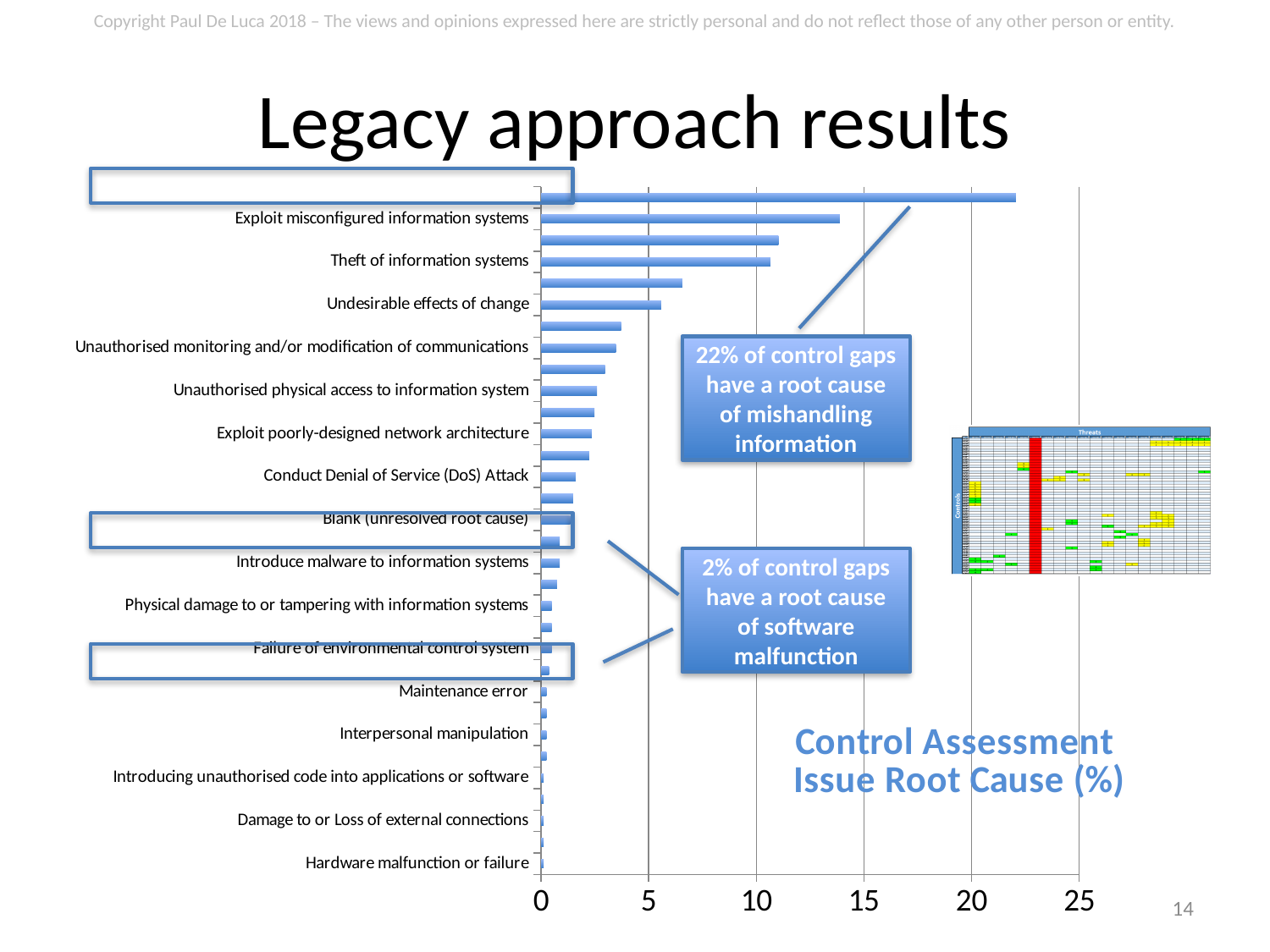
Which has the larger value: Exploit misconfigured information systems or Theft of information systems? Exploit misconfigured information systems What is the title of the chart? Control Assessment Issue Root Cause (%) What kind of chart is shown on the slide? Bar chart Which has the larger value: Undesirable effects of change or Conduct Denial of Service (DoS) Attack? Undesirable effects of change According to the callout on the chart, what percentage of control gaps have a root cause of software malfunction? 2% Is the value for Exploit misconfigured information systems greater or less than 10? greater According to the callout on the chart, what percentage of control gaps have a root cause of mishandling information? 22% Is the value for Theft of information systems greater or less than 15? less Is the value for Undesirable effects of change greater or less than 10? less Do the bar lengths increase or decrease going from the top of the chart to the bottom? decrease